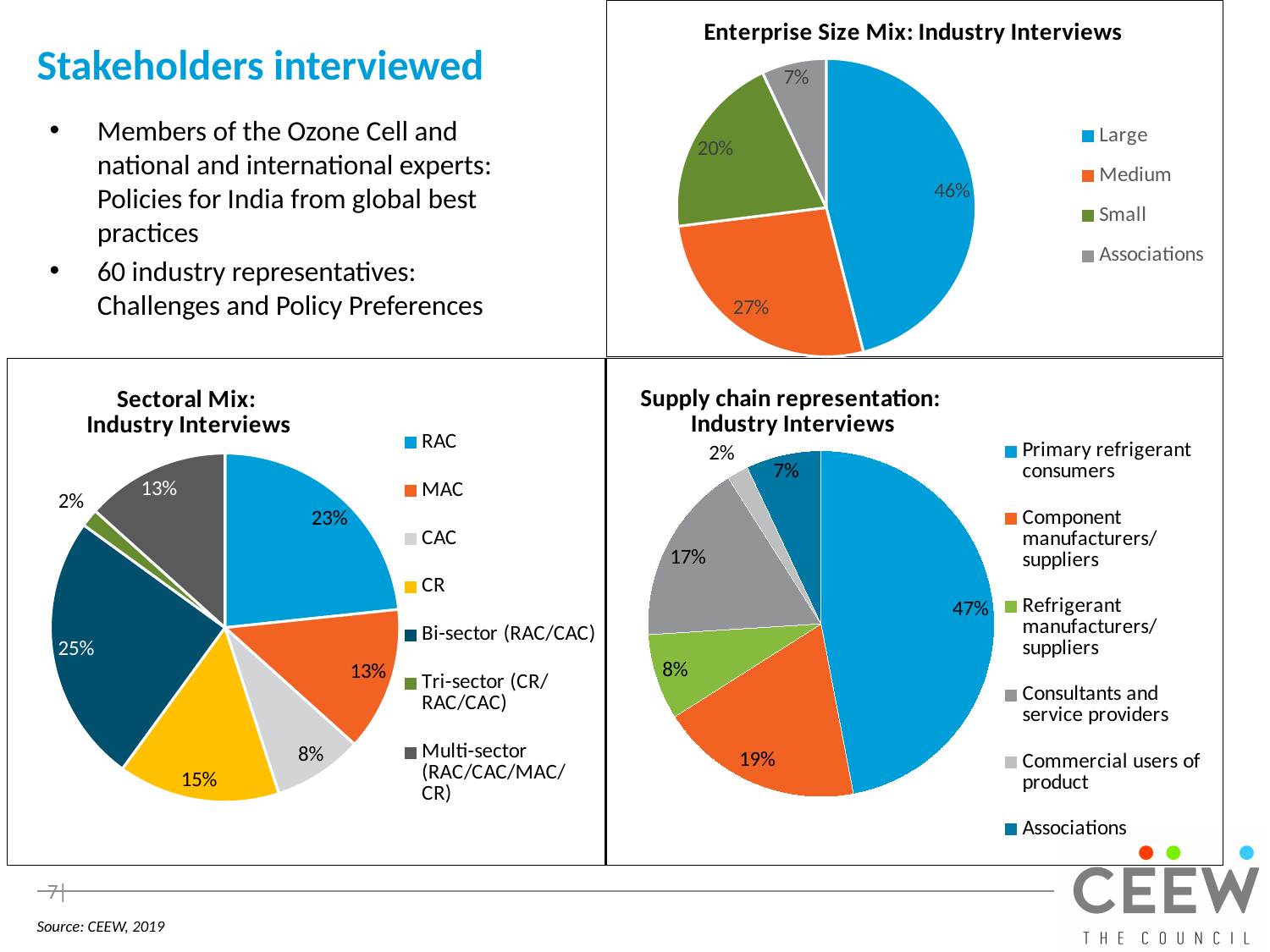
In the 'Enterprise Size Mix: Industry Interviews' chart, which category has the smallest share? Associations What kind of chart is the 'Supply chain representation: Industry Interviews' chart? Pie chart In the 'Enterprise Size Mix: Industry Interviews' chart, what is the difference between the Medium and Small shares? 7% In the 'Sectoral Mix: Industry Interviews' chart, which is larger, RAC or CR? RAC In the 'Supply chain representation: Industry Interviews' chart, what is the difference between Primary refrigerant consumers and Component manufacturers/suppliers? 28% In the 'Enterprise Size Mix: Industry Interviews' chart, what share is Large? 46% In the 'Sectoral Mix: Industry Interviews' chart, what share is Bi-sector (RAC/CAC)? 25% How many categories does the legend of the 'Sectoral Mix: Industry Interviews' chart list? 7 In the 'Supply chain representation: Industry Interviews' chart, which category has the smallest share? Commercial users of product In the 'Sectoral Mix: Industry Interviews' chart, which category has the largest share? Bi-sector (RAC/CAC) In the 'Supply chain representation: Industry Interviews' chart, what share is Consultants and service providers? 17% How many categories does the legend of the 'Enterprise Size Mix: Industry Interviews' chart list? 4